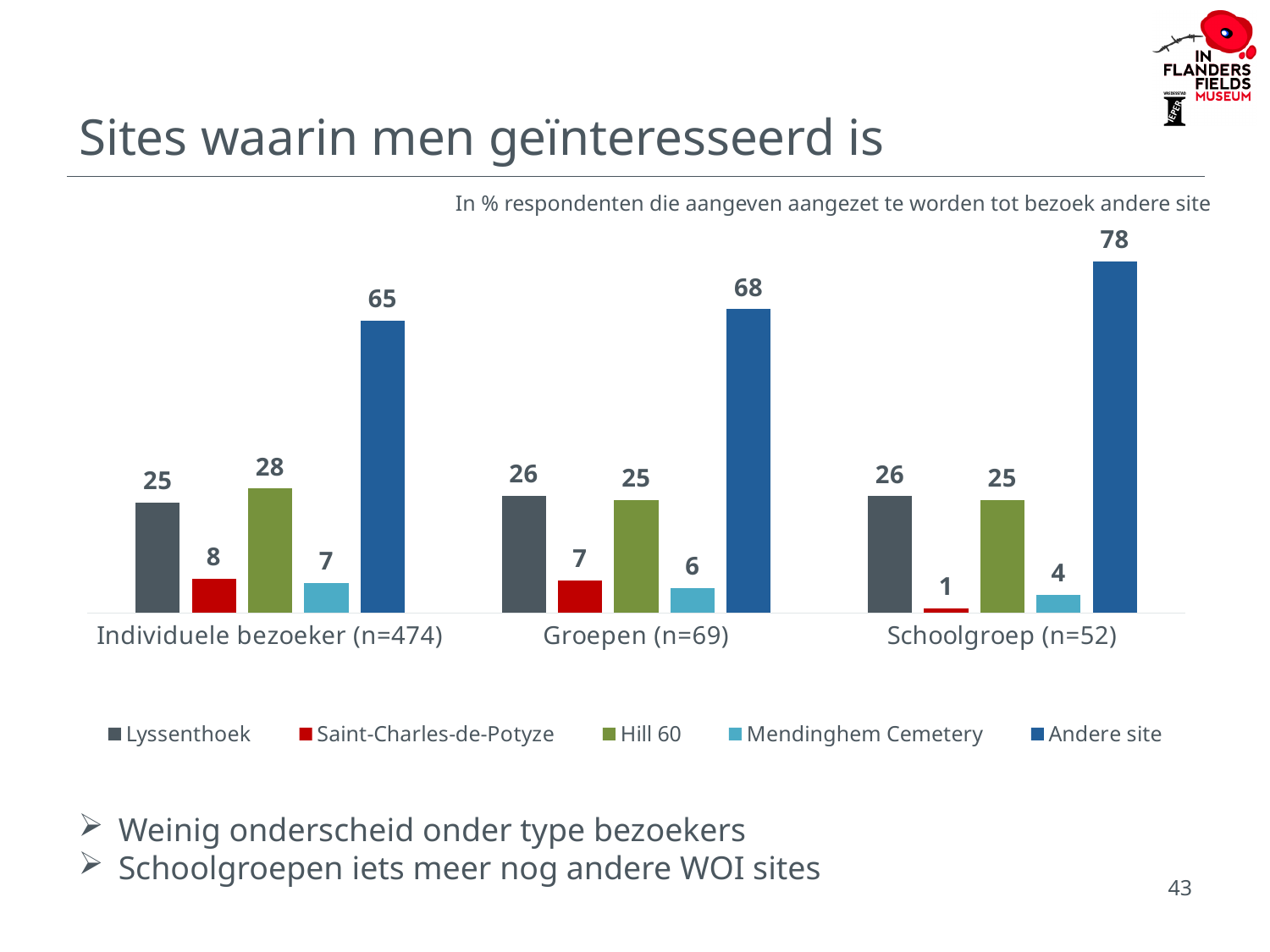
Which colour represents Hill 60 in the legend? Green How many series does the legend list? 5 What kind of chart is shown on the slide? Bar chart What is the difference between the Andere site values for Schoolgroep (n=52) and Individuele bezoeker (n=474)? 13 How many visitor groups are shown on the x axis? 3 What is the value for Hill 60 among Groepen (n=69)? 25 What is the value for Mendinghem Cemetery among Schoolgroep (n=52)? 4 Which site has the highest value among Individuele bezoeker (n=474)? Andere site What is the value for Saint-Charles-de-Potyze among Individuele bezoeker (n=474)? 8 Which is larger: Lyssenthoek for Groepen (n=69) or Hill 60 for Groepen (n=69)? Lyssenthoek What is the value for Andere site among Schoolgroep (n=52)? 78 Which site has the lowest value among Schoolgroep (n=52)? Saint-Charles-de-Potyze